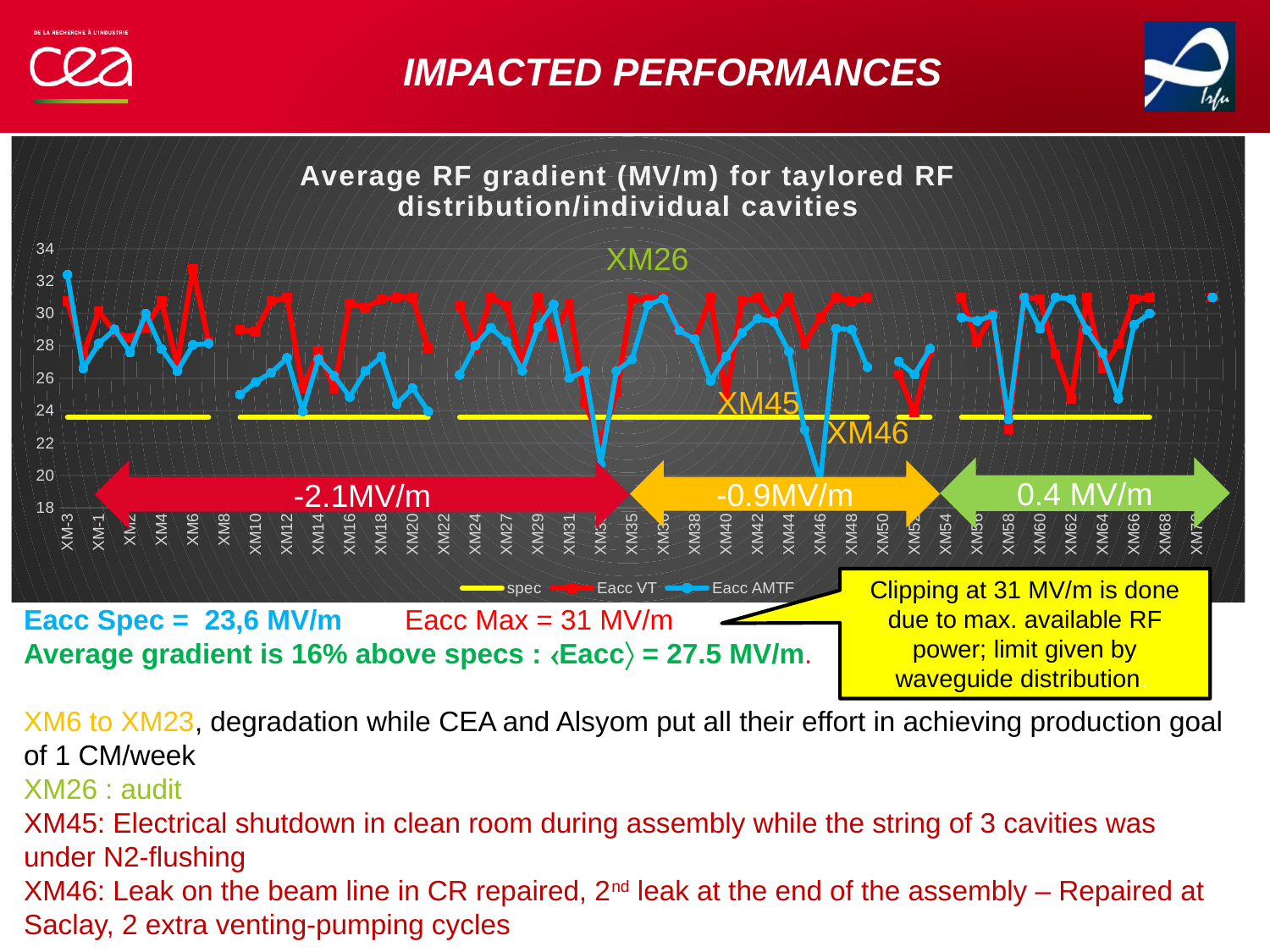
Is the Eacc AMTF value for XM-3 greater or less than 30? greater Which is larger at XM46, the Eacc VT value or the Eacc AMTF value? Eacc VT What kind of chart is shown on the slide? line chart What are the series names listed in the chart legend? spec, Eacc VT, Eacc AMTF Does the spec series rise, fall or stay flat along the x axis? stays flat Is the Eacc AMTF value for XM26 greater or less than 22? greater How many series does the chart legend list? 3 Is the spec series value greater or less than 22? greater Which is larger at XM-3, the Eacc AMTF value or the spec value? Eacc AMTF What is the title of the chart? Average RF gradient (MV/m) for taylored RF distribution/individual cavities